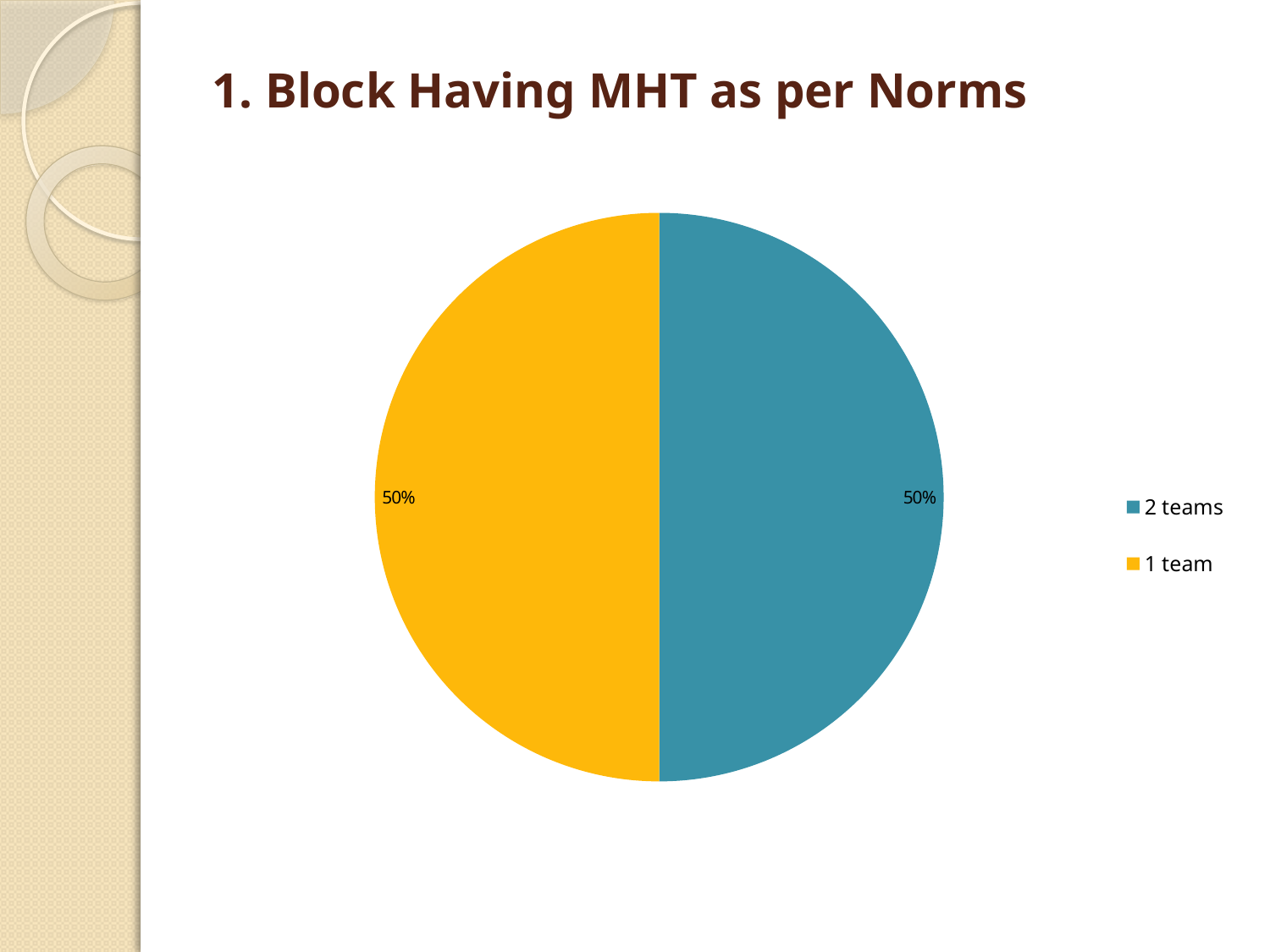
What is the difference between the "2 teams" share and the "1 team" share? 0% Which colour represents the "1 team" slice in the pie chart? yellow How many entries does the legend list? 2 How many slices does the pie chart have? 2 What share of the pie does the "2 teams" slice represent? 50% What kind of chart is shown on the slide? pie chart What is the title of the slide containing the pie chart? 1. Block Having MHT as per Norms What is the combined share of the "2 teams" and "1 team" slices? 100% What share of the pie does the "1 team" slice represent? 50%